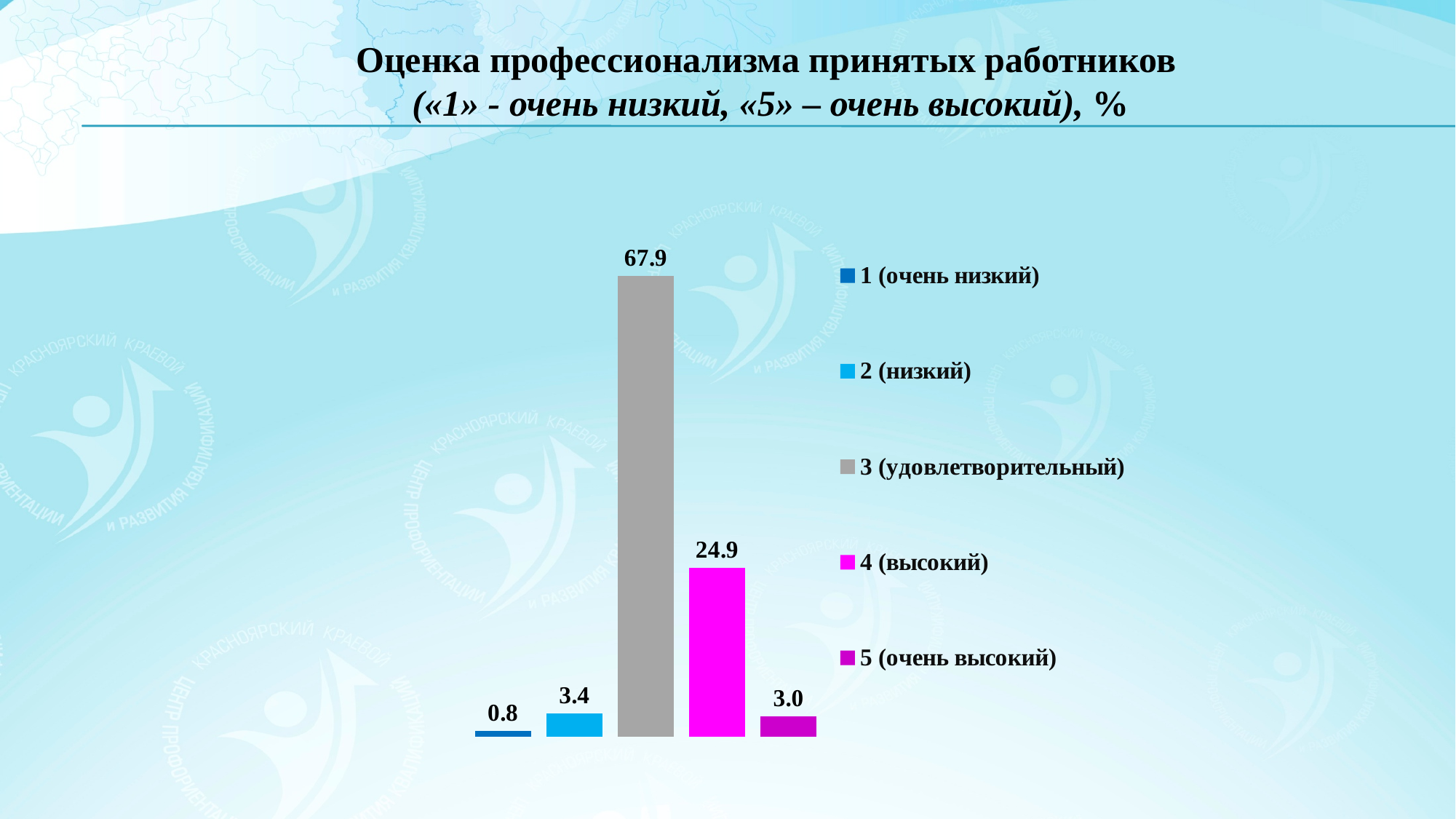
What colour is the bar for "4 (высокий)"? Magenta What kind of chart is shown on the slide? Bar chart What is the value for "5 (очень высокий)"? 3.0 How many categories are shown in the chart? 5 Which is larger, the value for "2 (низкий)" or the value for "5 (очень высокий)"? 2 (низкий) What is the value for "4 (высокий)"? 24.9 What is the value for "1 (очень низкий)"? 0.8 What is the difference between the values for "3 (удовлетворительный)" and "4 (высокий)"? 43.0 What is the value for "3 (удовлетворительный)"? 67.9 Which category has the lowest value? 1 (очень низкий) Which category has the highest value? 3 (удовлетворительный) How many entries does the legend list? 5